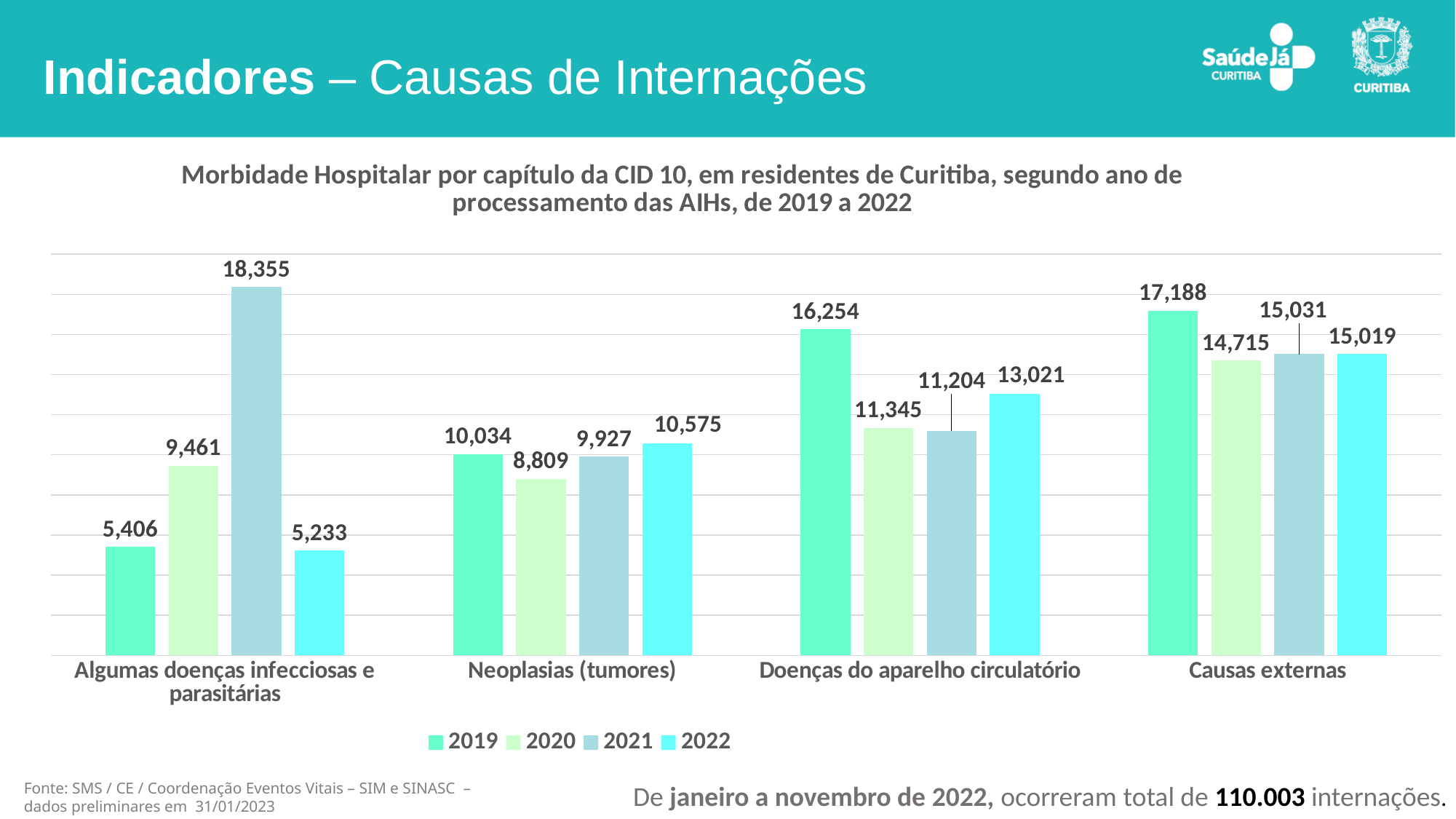
What is the difference between the 2019 and 2020 values in the 'Doenças do aparelho circulatório' category? 4,909 Which category has the lowest 2022 value? Algumas doenças infecciosas e parasitárias How many series does the legend list? 4 What is the value for 2019 in the 'Causas externas' category? 17,188 Which year has the lowest value in the 'Neoplasias (tumores)' category? 2020 Which is larger in the 'Causas externas' category: the 2020 value or the 2022 value? 2022 What kind of chart is shown on the slide? Bar chart What is the value for 2021 in the 'Algumas doenças infecciosas e parasitárias' category? 18,355 What is the value for 2020 in the 'Neoplasias (tumores)' category? 8,809 Which year has the highest value in the 'Algumas doenças infecciosas e parasitárias' category? 2021 What is the value for 2022 in the 'Doenças do aparelho circulatório' category? 13,021 How many categories are shown on the x axis? 4